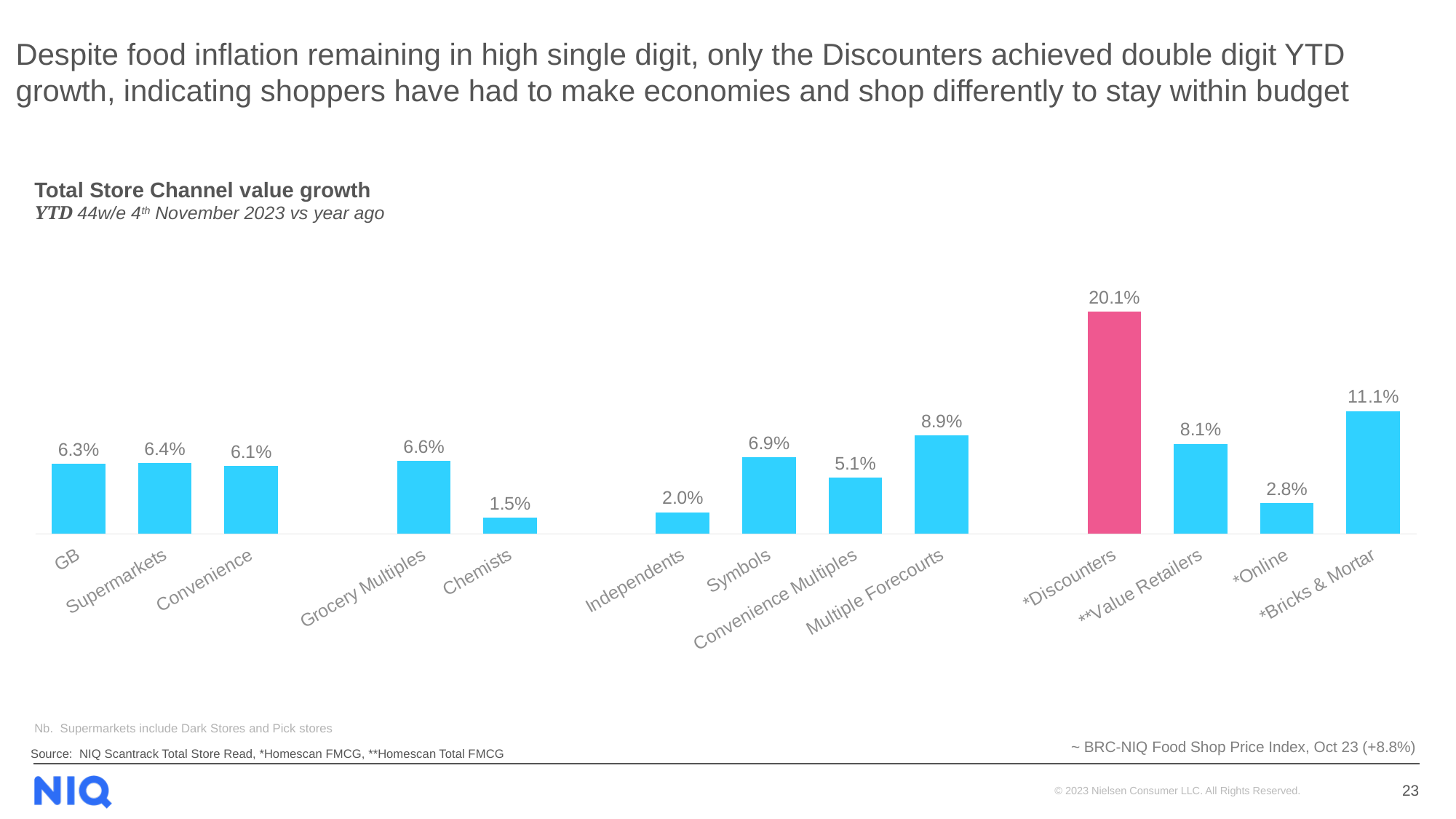
Which bar is coloured differently (pink) from the others? Discounters What is the value growth for Multiple Forecourts? 8.9% What is the value growth for Discounters? 20.1% What is the value growth for Online? 2.8% How many channels are shown in the chart? 14 Which has higher value growth, Symbols or Convenience Multiples? Symbols What is the title of the chart? Total Store Channel value growth What is the difference in value growth between Discounters and Bricks & Mortar? 9.0% What is the value growth for Chemists? 1.5% Which channel has the highest value growth? Discounters What kind of chart is shown on the slide? Bar chart Which channel has the lowest value growth? Chemists